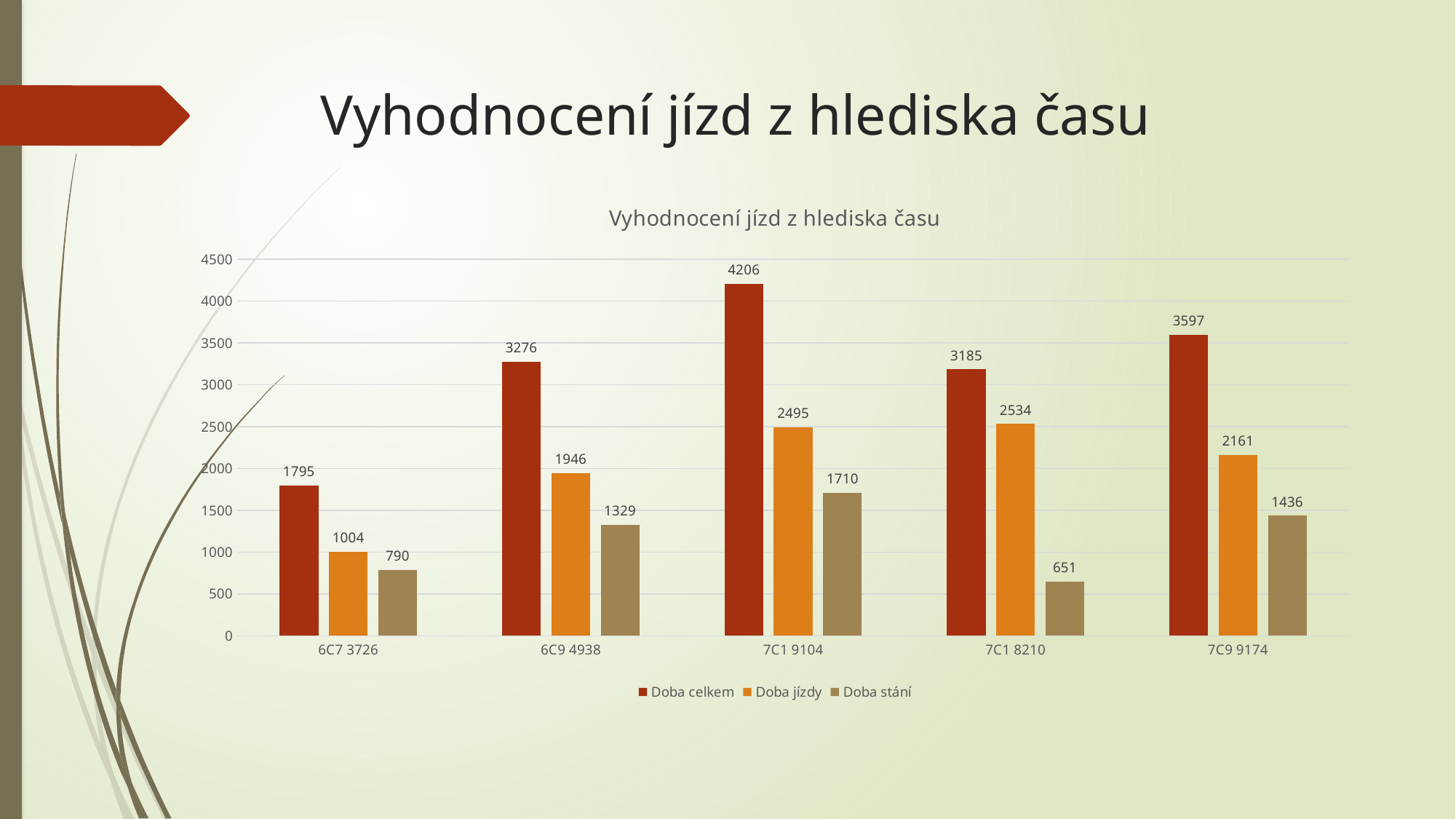
Which category has the lowest Doba stání value? 7C1 8210 How many series does the legend list? 3 What is the value of Doba jízdy for 6C9 4938? 1946 Which is larger, Doba jízdy for 7C1 8210 or Doba jízdy for 7C1 9104? Doba jízdy for 7C1 8210 What is the value of Doba stání for 7C1 8210? 651 How many categories are shown on the x axis? 5 What is the difference between Doba celkem and Doba jízdy for 7C9 9174? 1436 Which category has the highest Doba celkem value? 7C1 9104 What is the title of the chart? Vyhodnocení jízd z hlediska času Is the value of Doba celkem for 6C7 3726 greater or less than 2000? less What is the value of Doba celkem for 7C1 9104? 4206 What kind of chart is shown on the slide? bar chart